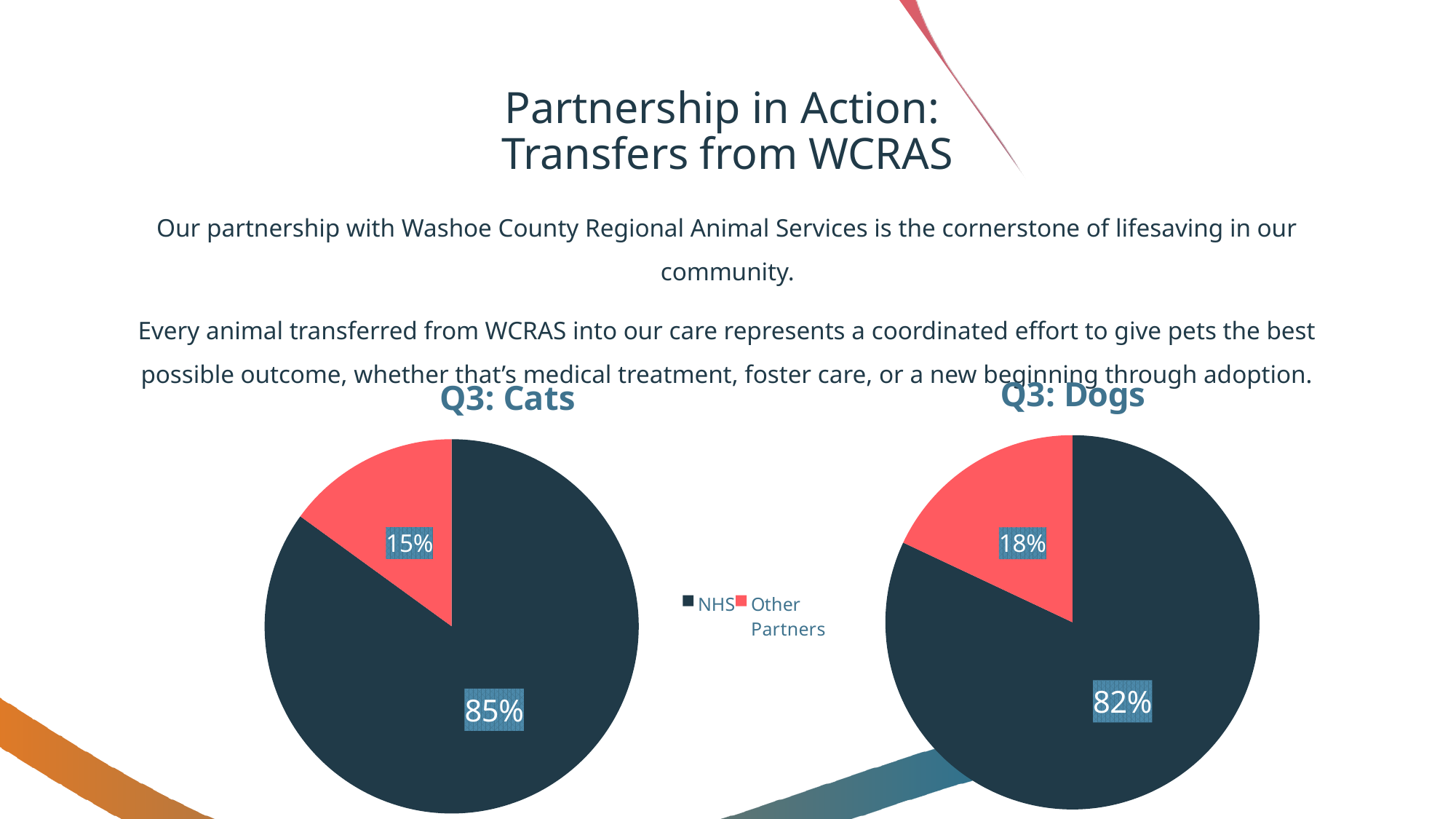
What type of chart is the Q3: Dogs chart? Pie chart In the Q3: Cats chart, what is the difference between the NHS share and the Other Partners share? 70% How many slices does the Q3: Cats pie chart have? 2 In the Q3: Dogs chart, what share of transfers went to Other Partners? 18% How many entries does the legend list? 2 In the Q3: Dogs chart, what share of transfers went to NHS? 82% In the Q3: Cats chart, which slice is the largest? NHS In the Q3: Cats chart, what share of transfers went to Other Partners? 15% In the Q3: Dogs chart, which slice is the smallest? Other Partners Which colour represents Other Partners in the charts? Red In the Q3: Cats chart, what share of transfers went to NHS? 85% Is the NHS share larger in the Q3: Cats chart or the Q3: Dogs chart? Q3: Cats